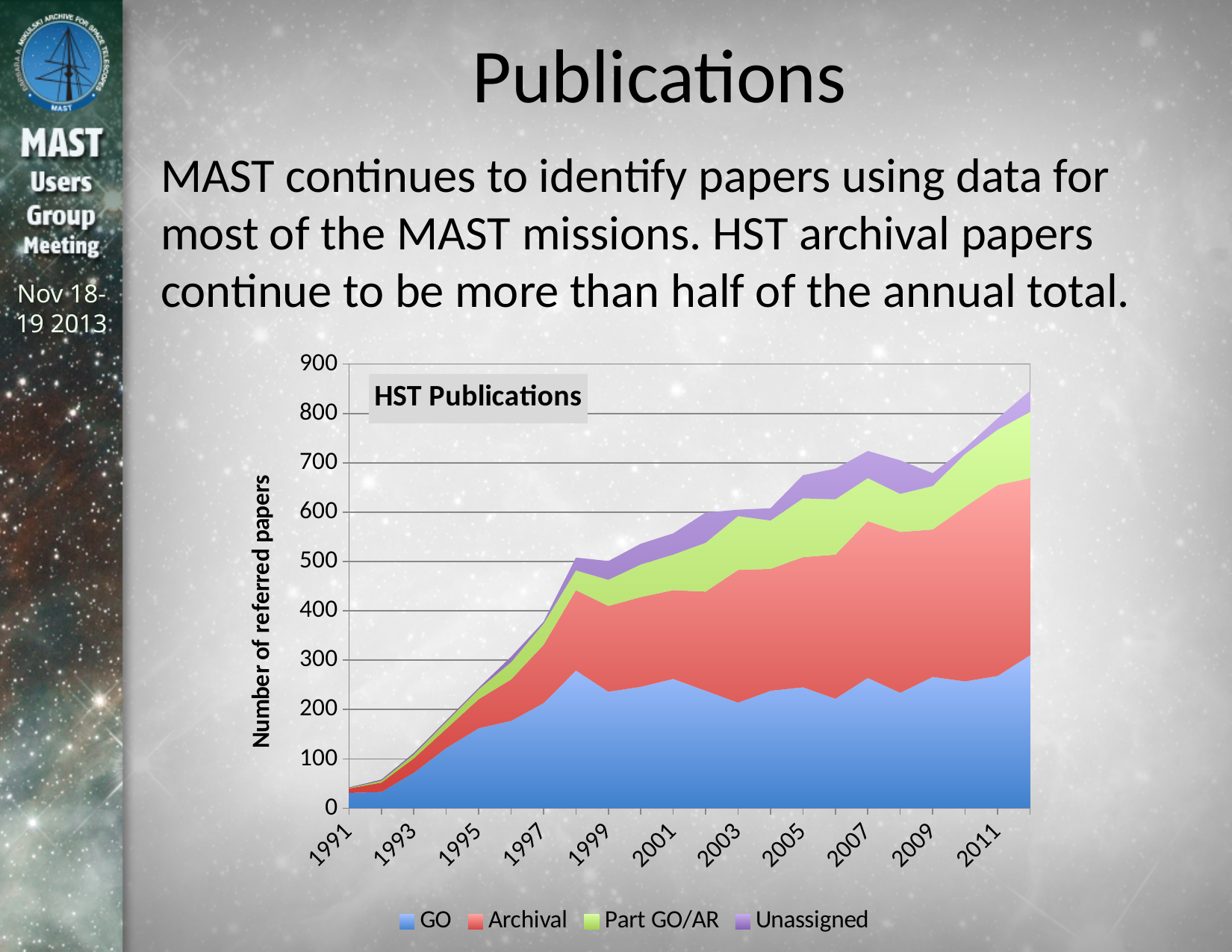
How many year labels are shown on the x axis of the HST Publications chart? 11 In 2011, which series contributes more papers, Archival or Unassigned? Archival Is the total number of HST publications in 2005 greater or less than 600? greater What kind of chart is the HST Publications chart? Stacked area chart Is the total number of HST publications in 2001 greater or less than 500? greater How many series does the legend of the HST Publications chart list? 4 What is the label on the vertical axis of the HST Publications chart? Number of referred papers Does the total number of HST publications generally rise or fall from 1991 to the end of the series? Rise Is the total number of HST publications in 1991 greater or less than 100? less What are the series names in the legend of the HST Publications chart? GO, Archival, Part GO/AR, Unassigned